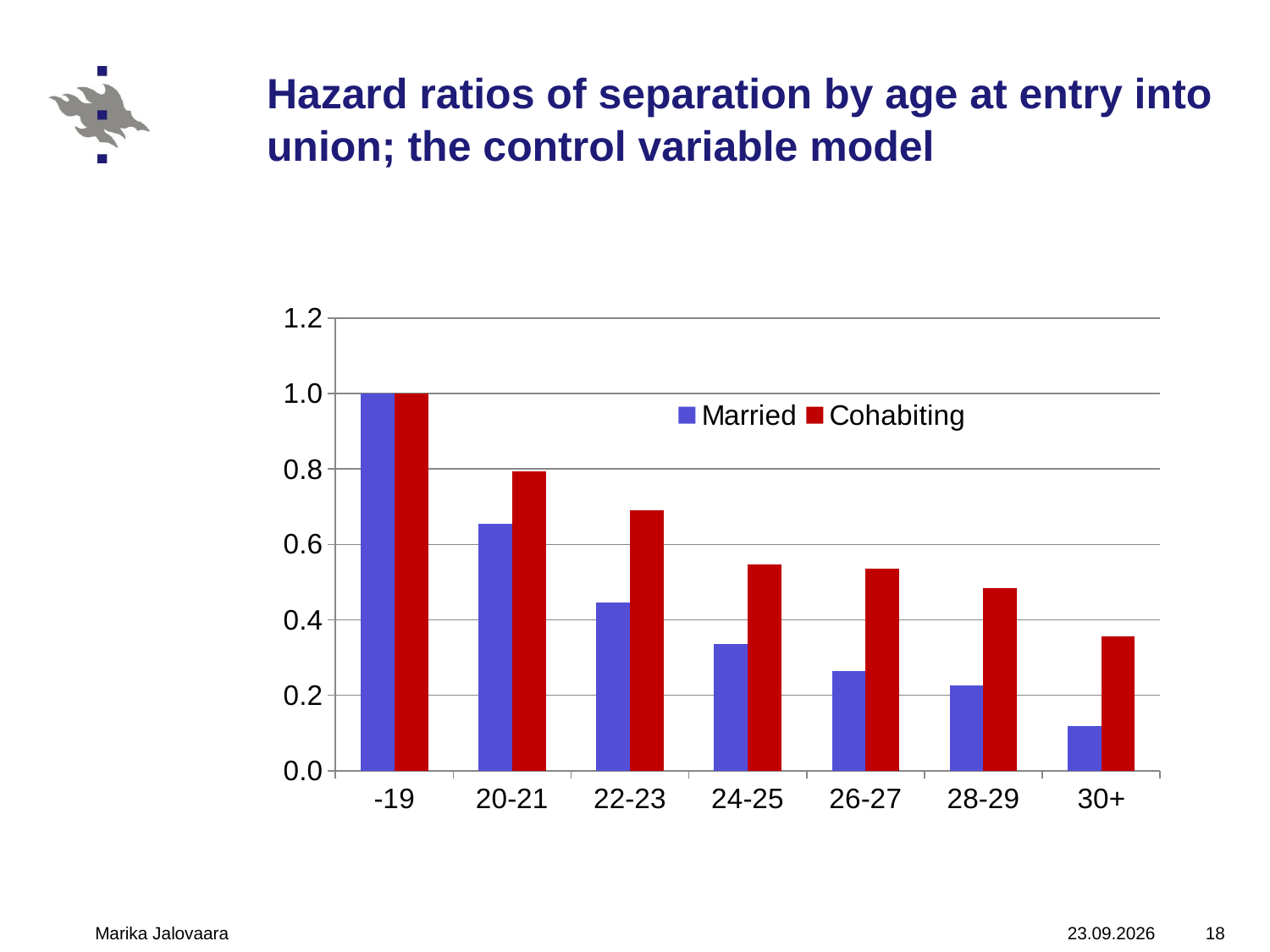
How many series does the legend list? 2 Which age group has the lowest hazard ratio for Married? 30+ Which age group has the highest hazard ratio for Cohabiting? -19 What type of chart is shown on the slide? bar chart What is the hazard ratio for Married in the -19 age group? 1.0 Do the Married hazard ratios rise or fall as age at entry into union increases? fall Is the Married value for 30+ greater or less than 0.2? less Is the Cohabiting value for 24-25 greater or less than 0.4? greater For the 26-27 age group, which series has the larger hazard ratio, Married or Cohabiting? Cohabiting How many age-at-entry categories are shown on the x axis? 7 What is the hazard ratio for Cohabiting in the -19 age group? 1.0 Is the Married value for 24-25 greater or less than 0.4? less